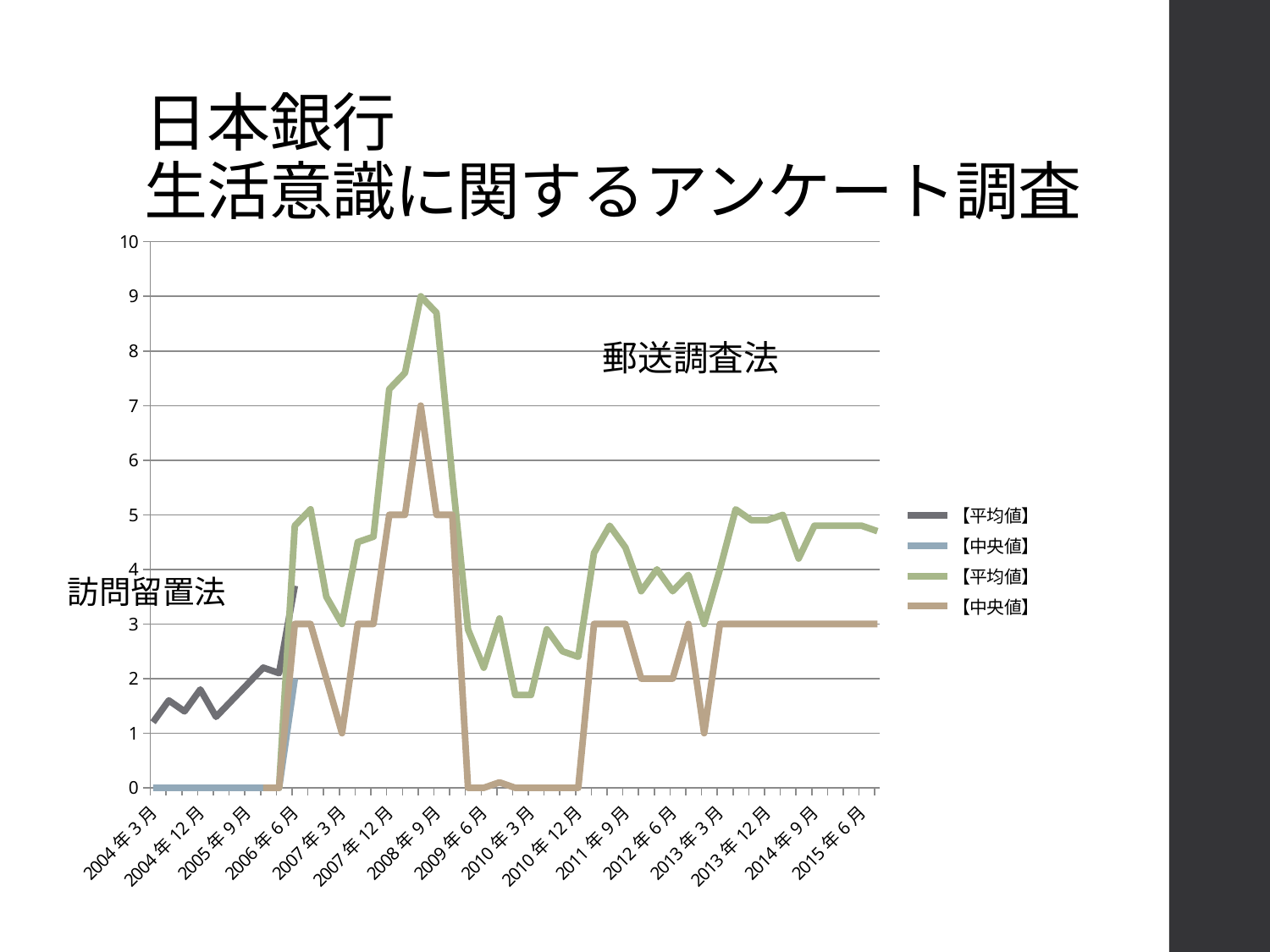
How many labels are shown on the x axis? 16 Is the value of the dark gray 【平均値】 line at 2004年3月 greater or less than 2? less Is the value of the tan 【中央値】 line at 2010年3月 greater or less than 1? less Is the value of the green 【平均値】 line at 2008年9月 greater or less than 8? greater At 2008年9月, which is larger: the green 【平均値】 line or the tan 【中央値】 line? green 【平均値】 What two survey-method annotations are written on the chart area? 訪問留置法 and 郵送調査法 What kind of chart is shown on the slide? line chart What is the value of the tan 【中央値】 line at 2008年9月? 5 What is the value of the tan 【中央値】 line at 2015年6月? 3 How many series does the legend list? 4 Does the dark gray 【平均値】 line rise or fall overall from 2004年3月 to 2006年6月? rise